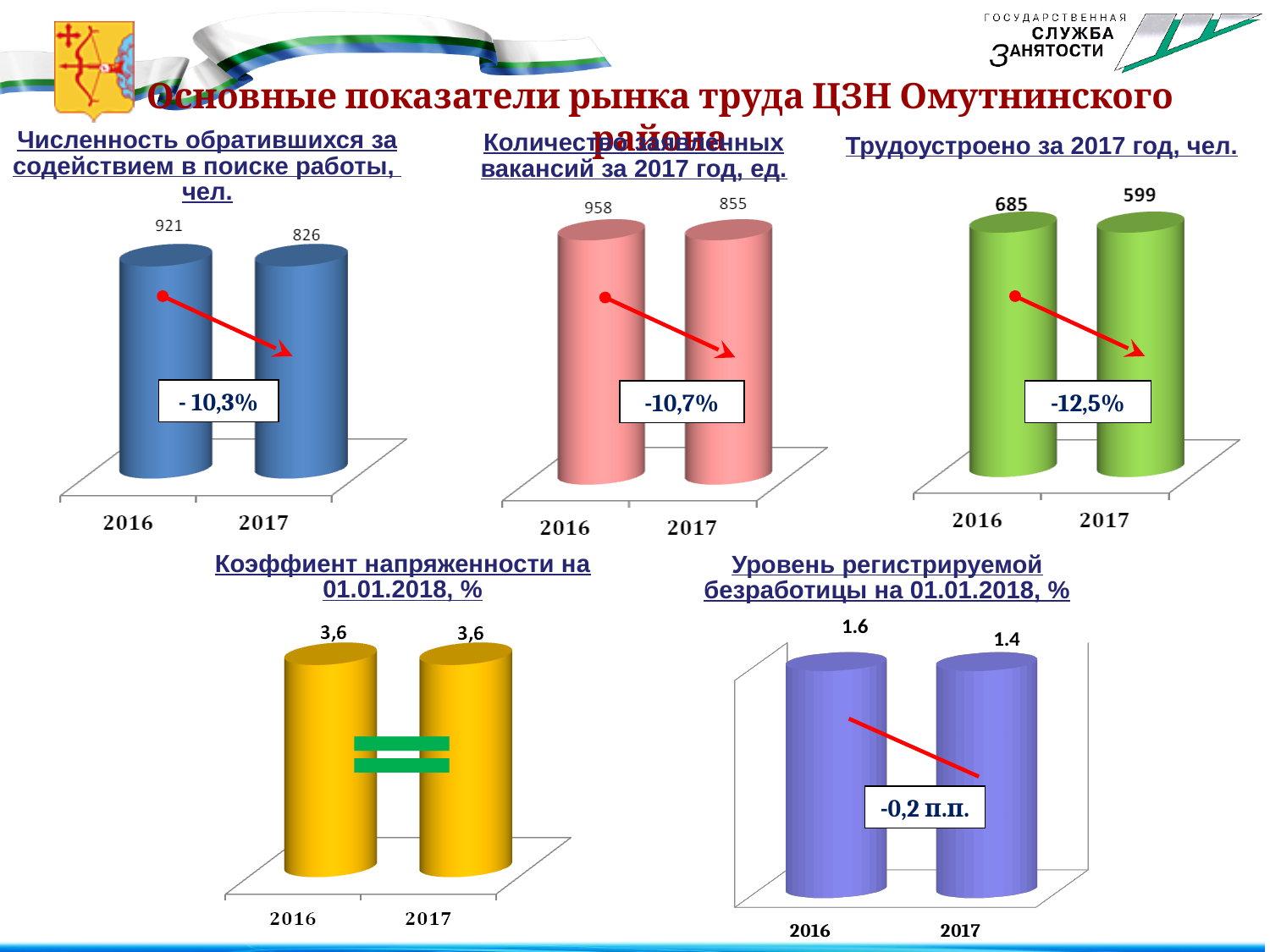
In the bottom-right chart (Уровень регистрируемой безработицы на 01.01.2018, %), do the values rise or fall from 2016 to 2017? fall In the bottom-left chart (Коэффиент напряженности на 01.01.2018, %), what is the value for 2017? 3,6 In the top-middle chart (Количество заявленных вакансий за 2017 год, ед.), what is the value for 2017? 855 How many categories (years) are shown on the x axis of the top-left chart (Численность обратившихся за содействием в поиске работы, чел.)? 2 In the top-middle chart (Количество заявленных вакансий за 2017 год, ед.), which year has the higher value? 2016 In the top-right chart (Трудоустроено за 2017 год, чел.), what is the value for 2017? 599 In the bottom-right chart (Уровень регистрируемой безработицы на 01.01.2018, %), what is the value for 2016? 1.6 In the top-right chart (Трудоустроено за 2017 год, чел.), what percentage change is annotated on the chart? -12,5% In the top-left chart (Численность обратившихся за содействием в поиске работы, чел.), what is the difference between the 2016 and 2017 values? 95 In the bottom-left chart (Коэффиент напряженности на 01.01.2018, %), do the values rise, fall or stay the same from 2016 to 2017? stay the same In the top-left chart (Численность обратившихся за содействием в поиске работы, чел.), what is the value for 2016? 921 In the top-right chart (Трудоустроено за 2017 год, чел.), what is the difference between the 2016 and 2017 values? 86